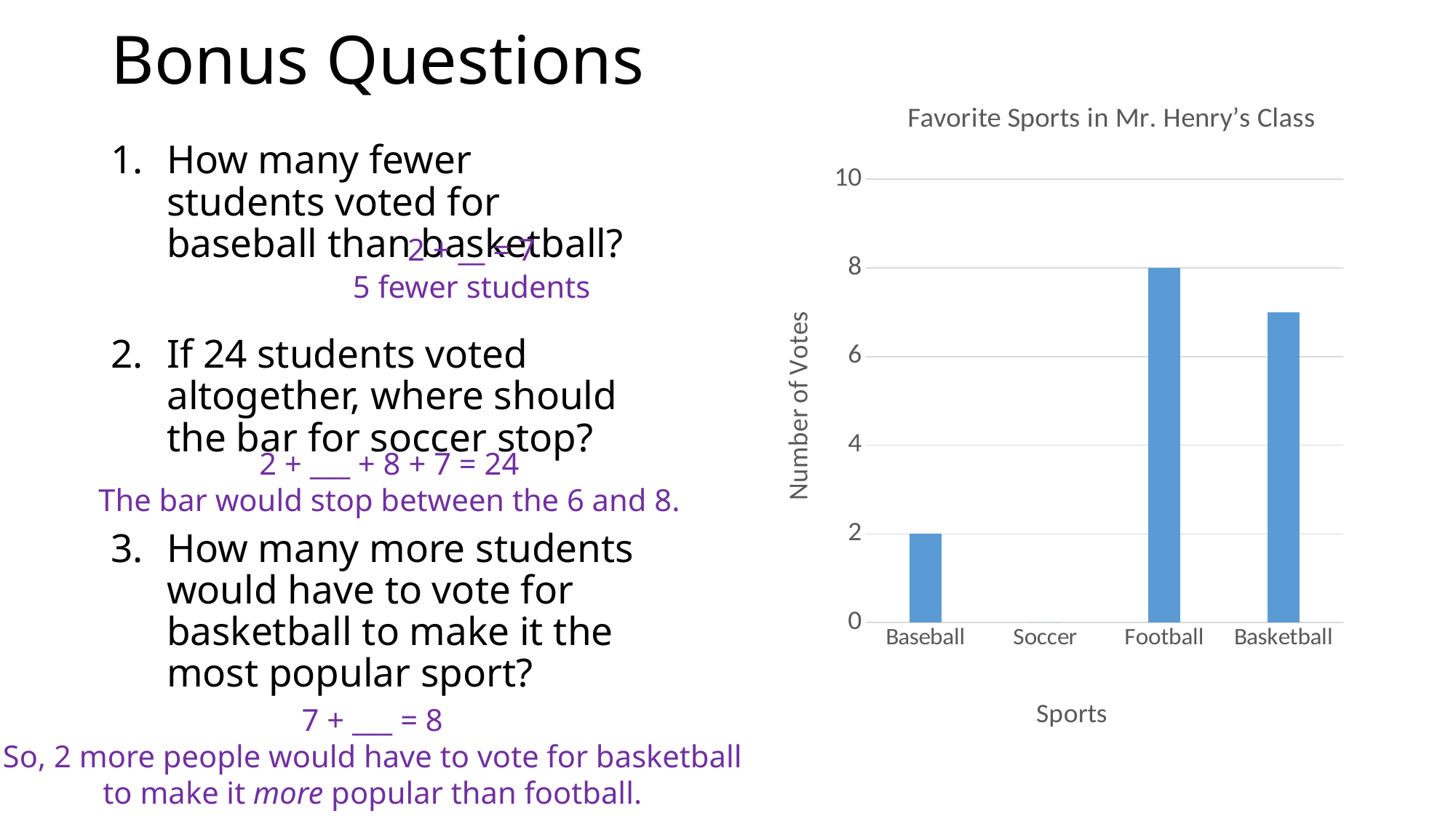
Is the value for Basketball greater or less than 8? less Which sport has the tallest bar in the chart? Football What is the title of the chart? Favorite Sports in Mr. Henry's Class What is the label of the vertical axis of the chart? Number of Votes Which has more votes, Basketball or Baseball? Basketball How many votes does the bar for Baseball show? 2 Which sport on the x axis has no bar drawn in the chart? Soccer What kind of chart is shown on the slide? bar chart Is the value for Basketball greater or less than 6? greater How many votes does the bar for Football show? 8 How many more votes does Football have than Baseball? 6 How many sports are listed on the x axis of the chart? 4